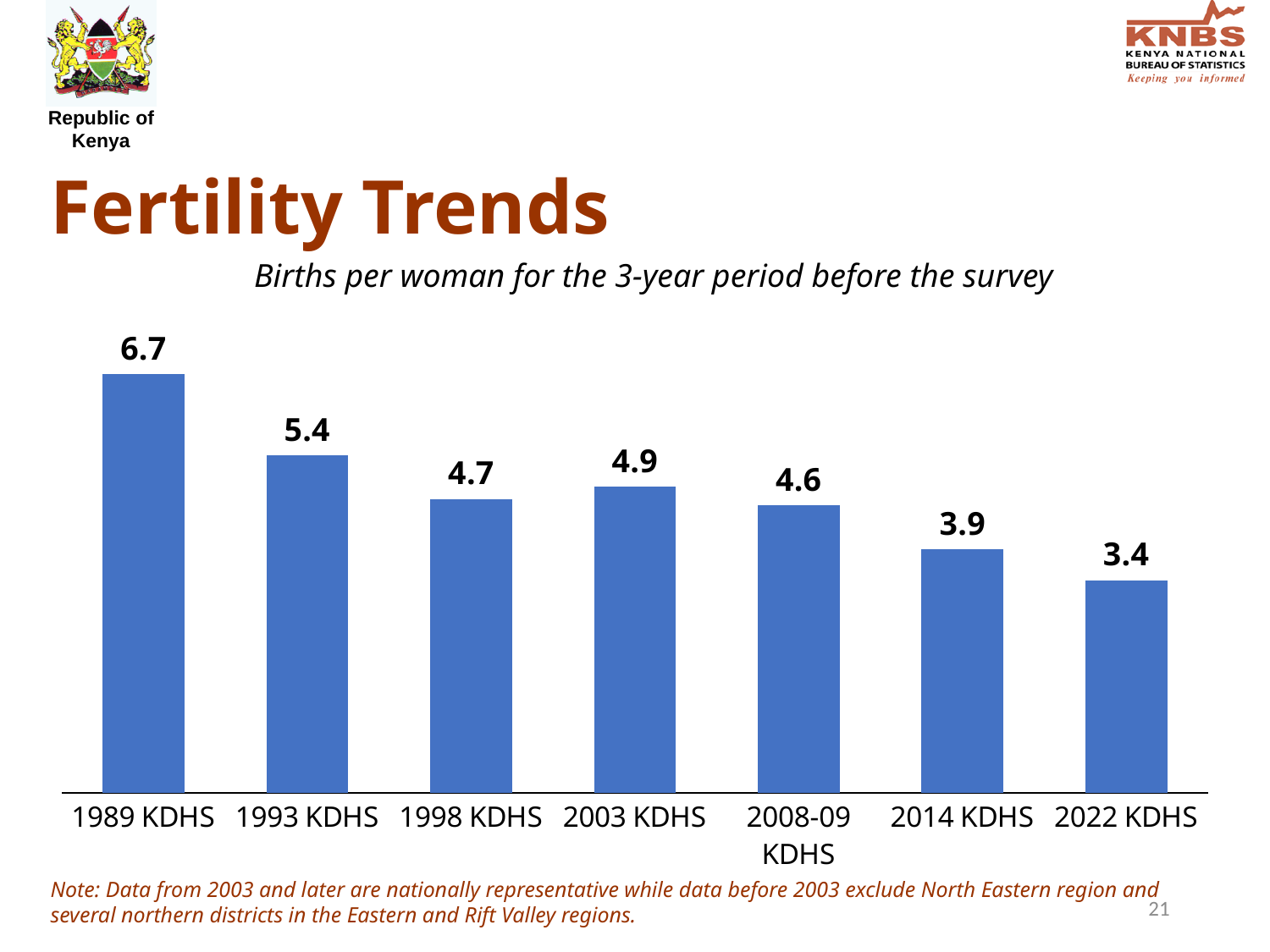
What is the value for 2022 KDHS? 3.4 What is the difference between the values for 1989 KDHS and 2022 KDHS? 3.3 Which survey has the highest births per woman? 1989 KDHS Which survey has the lowest births per woman? 2022 KDHS What kind of chart is shown on the slide? Bar chart Which is larger, the value for 2003 KDHS or the value for 2014 KDHS? 2003 KDHS What is the title of the chart? Fertility Trends What is the value for 2008-09 KDHS? 4.6 What is the value for 1989 KDHS? 6.7 What is the difference between the values for 1998 KDHS and 2003 KDHS? 0.2 Do the values generally rise or fall from 1989 KDHS to 2022 KDHS? Fall How many surveys are shown on the chart? 7